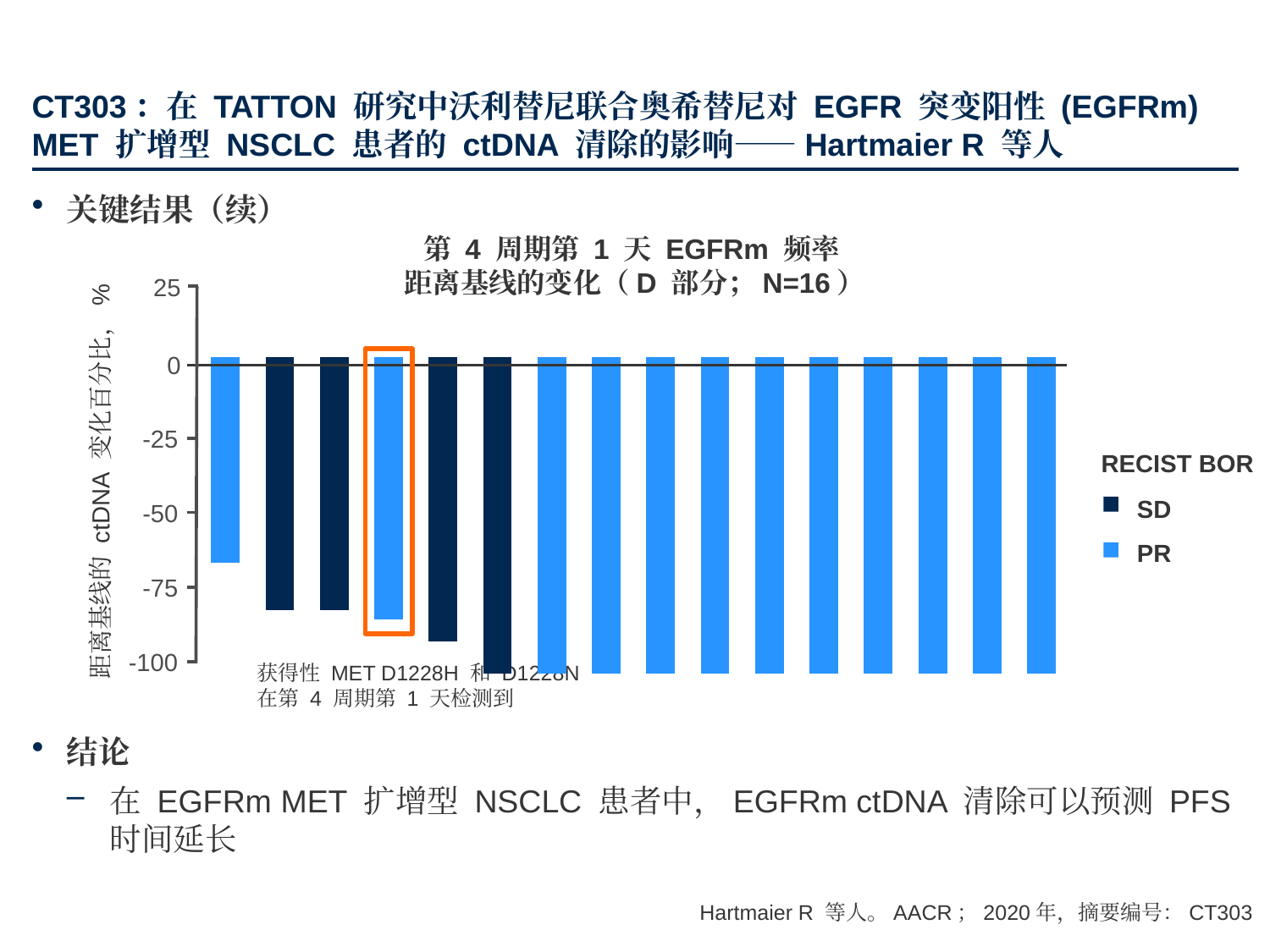
What kind of chart is shown on the slide? bar chart How many bars (patients) are plotted in the chart? 16 How many bars belong to the SD (dark blue) series? 4 Do the bar values rise or fall moving from left to right along the x axis? fall Is the value of the second bar from the left greater or less than -75? less Which is larger, the value of the leftmost bar or the value of the second bar from the left? the leftmost bar Which bar has the highest (least negative) value? the leftmost bar Is the value of the leftmost bar greater or less than -75? greater How many bars belong to the PR (light blue) series? 12 Is the value of the leftmost bar greater or less than -50? less What are the two entries in the RECIST BOR legend? SD and PR How many series does the legend list? 2